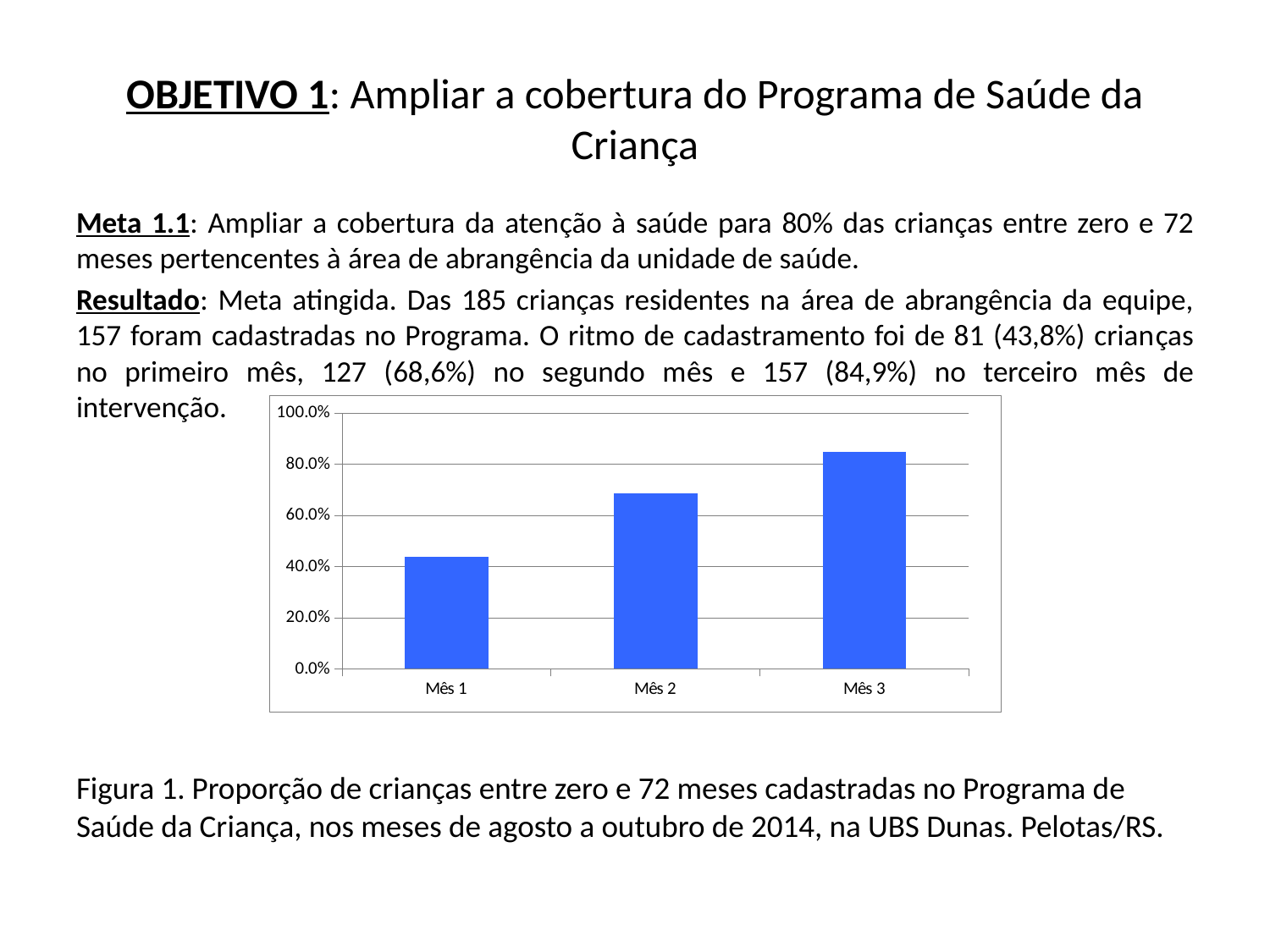
Which month has the highest bar in the chart? Mês 3 Do the values rise or fall from Mês 1 to Mês 3? rise How many categories (months) are plotted on the x axis of the chart? 3 Is the value for Mês 1 greater or less than 40.0%? greater What is the highest tick value shown on the y axis of the chart? 100.0% Which is larger, the value for Mês 2 or the value for Mês 3? Mês 3 Which month has the lowest bar in the chart? Mês 1 What colour are the bars in the chart? blue Is the value for Mês 3 greater or less than 80.0%? greater Is the value for Mês 1 greater or less than 60.0%? less What kind of chart is shown on the slide? bar chart